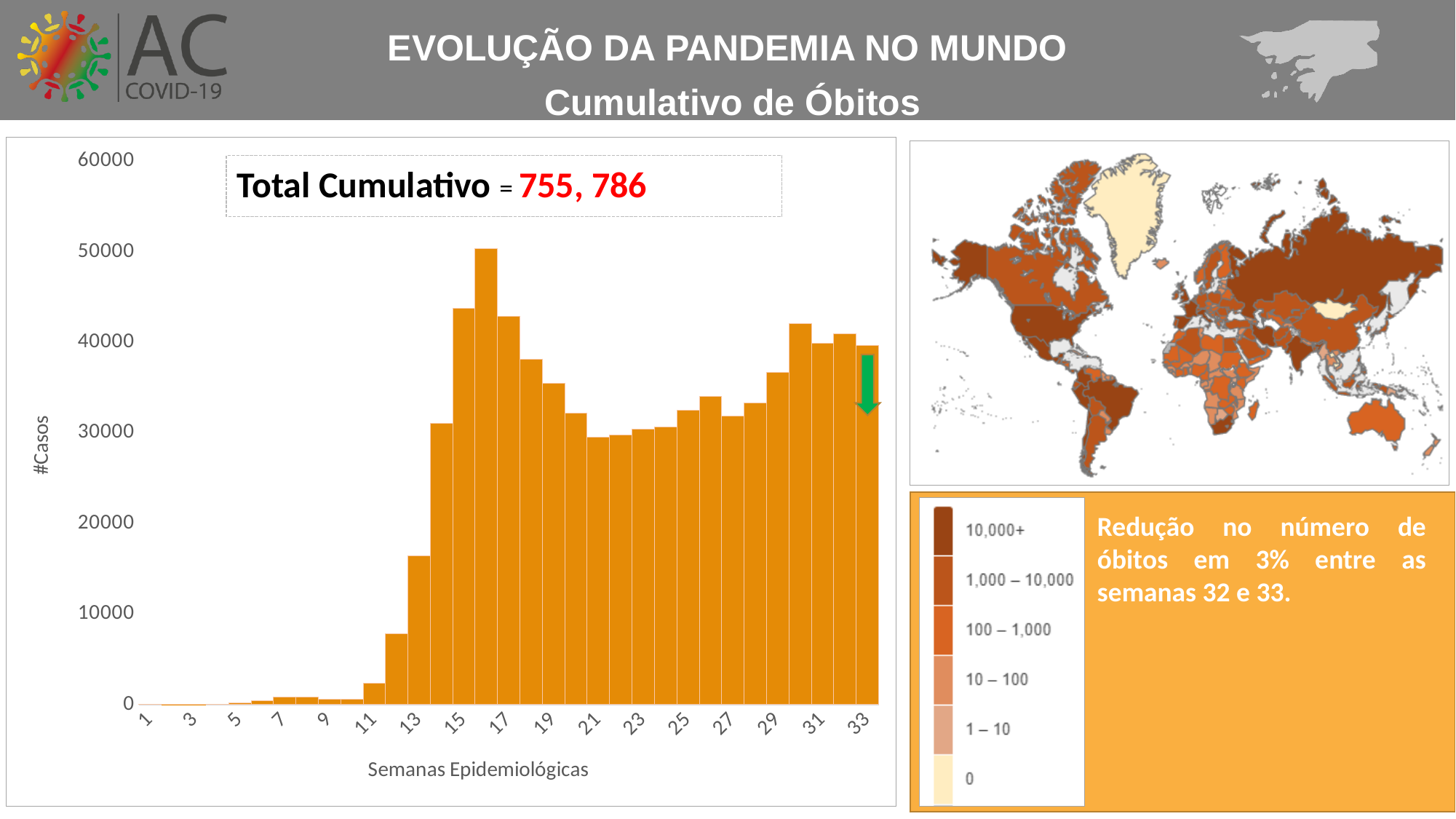
In the bar chart, do the values rise or fall from week 16 to week 21? fall What kind of chart is shown on the left of the slide? bar chart How many epidemiological weeks (bars) are plotted in the bar chart? 33 What is the label of the x axis of the bar chart? Semanas Epidemiológicas In the bar chart, is the value for week 12 greater or less than 10000? less In the bar chart, is the value for week 19 greater or less than 40000? less In the bar chart, is the value for week 33 greater or less than 30000? greater In the bar chart, which is larger, the value for week 16 or the value for week 17? week 16 In the bar chart, which is larger, the value for week 13 or the value for week 14? week 14 In the bar chart, which epidemiological week has the highest number of deaths? 16